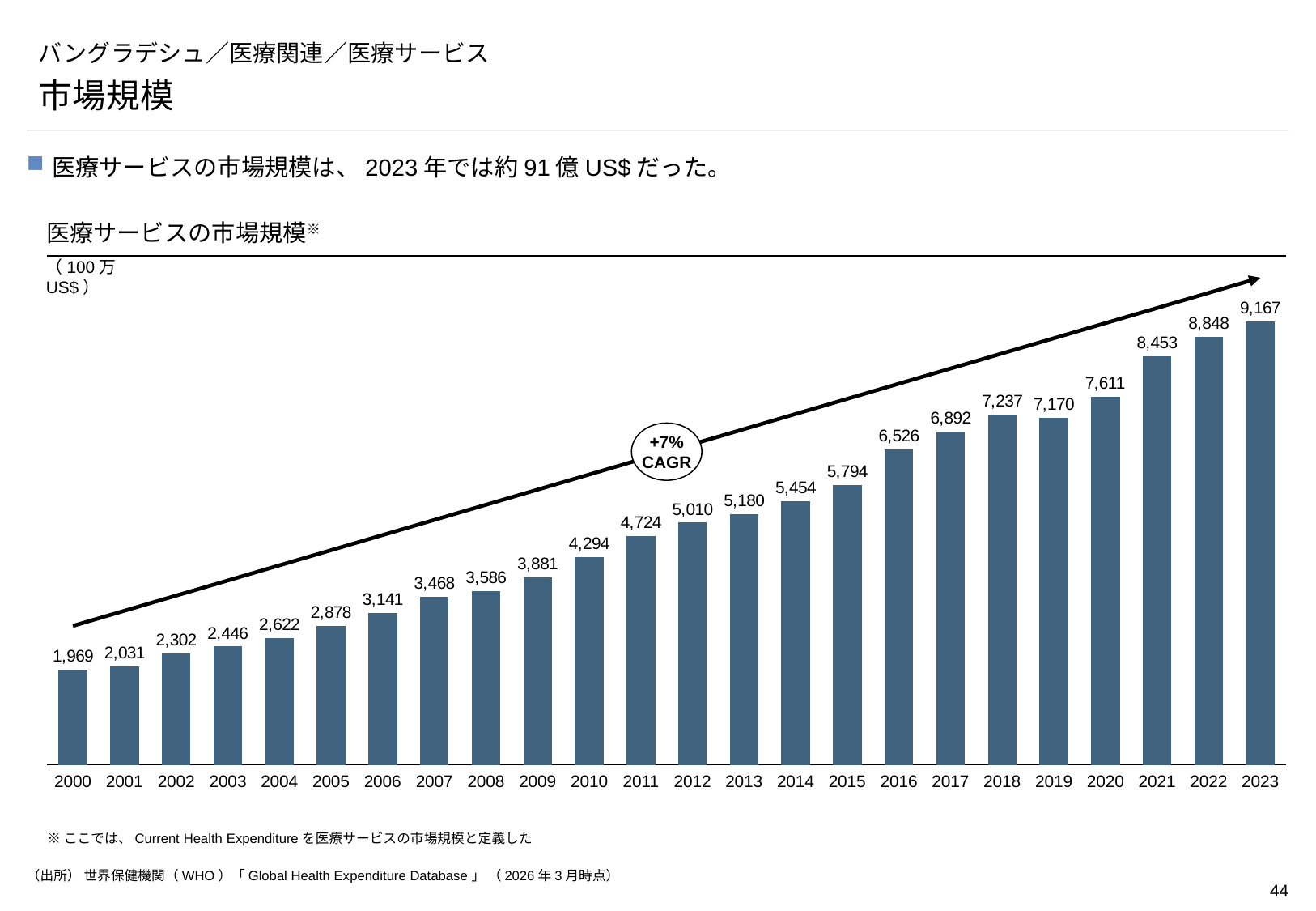
What is the difference between the values for 2018 and 2019? 67 How many years are shown on the x axis of the chart? 24 What is the value for 2016 in the chart? 6,526 What kind of chart is shown on the slide? Bar chart Which is larger, the value for 2018 or the value for 2019? 2018 Which year has the highest value in the chart? 2023 Which year has the lowest value in the chart? 2000 What is the difference between the values for 2023 and 2000? 7,198 Do the values generally rise or fall from 2000 to 2023? Rise What CAGR is shown on the arrow in the chart? +7% What is the value for 2023 in the 医療サービスの市場規模 chart? 9,167 What is the value for 2000 in the chart? 1,969